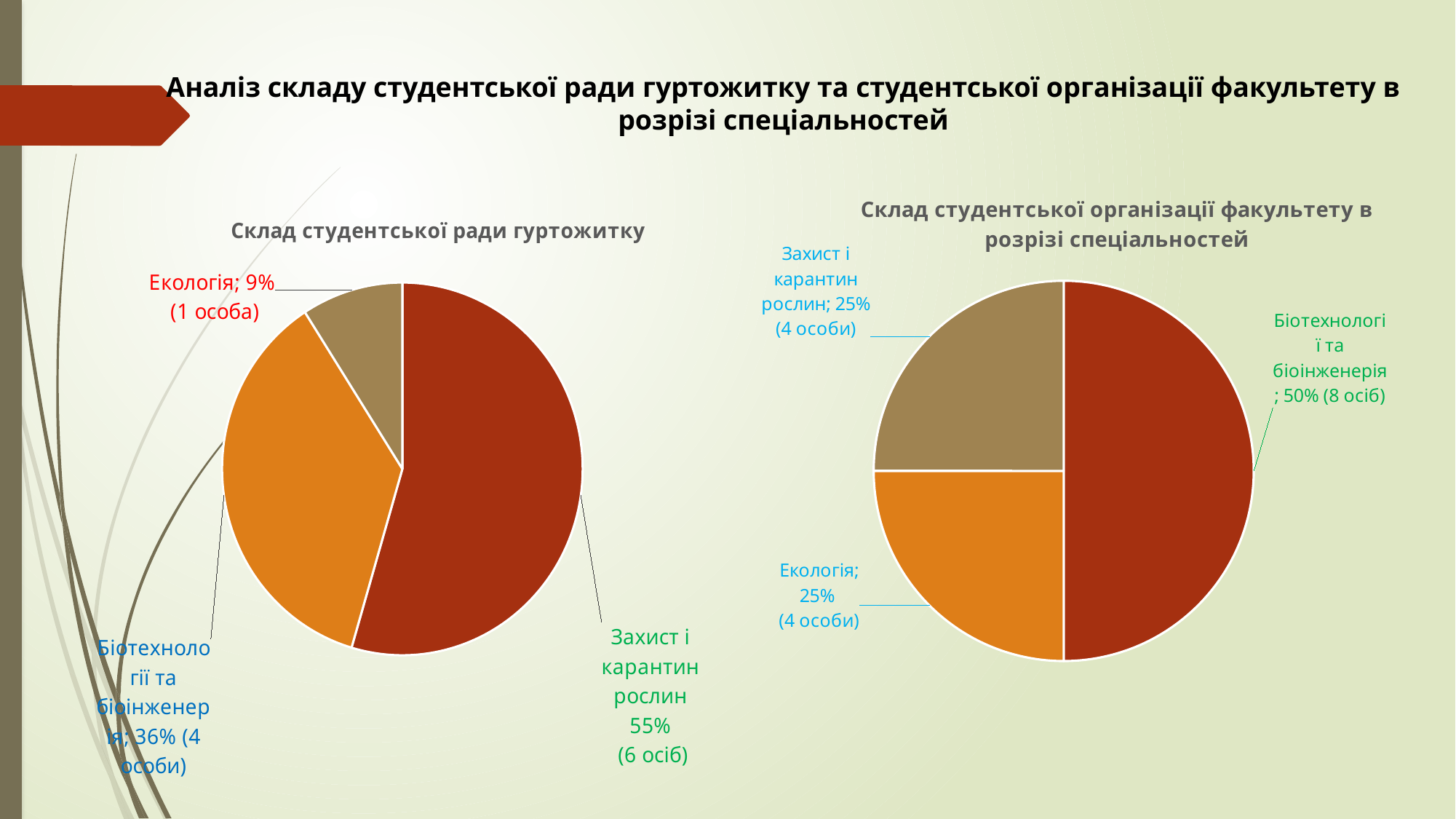
In the chart titled "Склад студентської ради гуртожитку", which category has the largest slice? Захист і карантин рослин What type of chart is used on the right side of the slide? Pie chart In the chart titled "Склад студентської ради гуртожитку", which category has the smallest slice? Екологія In the chart titled "Склад студентської ради гуртожитку", what share does "Захист і карантин рослин" have? 55% In the chart titled "Склад студентської організації факультету в розрізі спеціальностей", what share does "Біотехнології та біоінженерія" have? 50% In the chart titled "Склад студентської організації факультету в розрізі спеціальностей", which category has the largest slice? Біотехнології та біоінженерія In the chart titled "Склад студентської організації факультету в розрізі спеціальностей", how many people are in the "Екологія" slice? 4 особи In the chart titled "Склад студентської ради гуртожитку", how many people are in the "Екологія" slice? 1 особа In the chart titled "Склад студентської ради гуртожитку", how many slices does the pie have? 3 In the chart titled "Склад студентської організації факультету в розрізі спеціальностей", how many people are in the "Біотехнології та біоінженерія" slice? 8 осіб Which slice is larger: "Біотехнології та біоінженерія" in the left chart or "Біотехнології та біоінженерія" in the right chart? The right chart (50%) In the chart titled "Склад студентської ради гуртожитку", what is the difference in percentage points between "Захист і карантин рослин" and "Біотехнології та біоінженерія"? 19